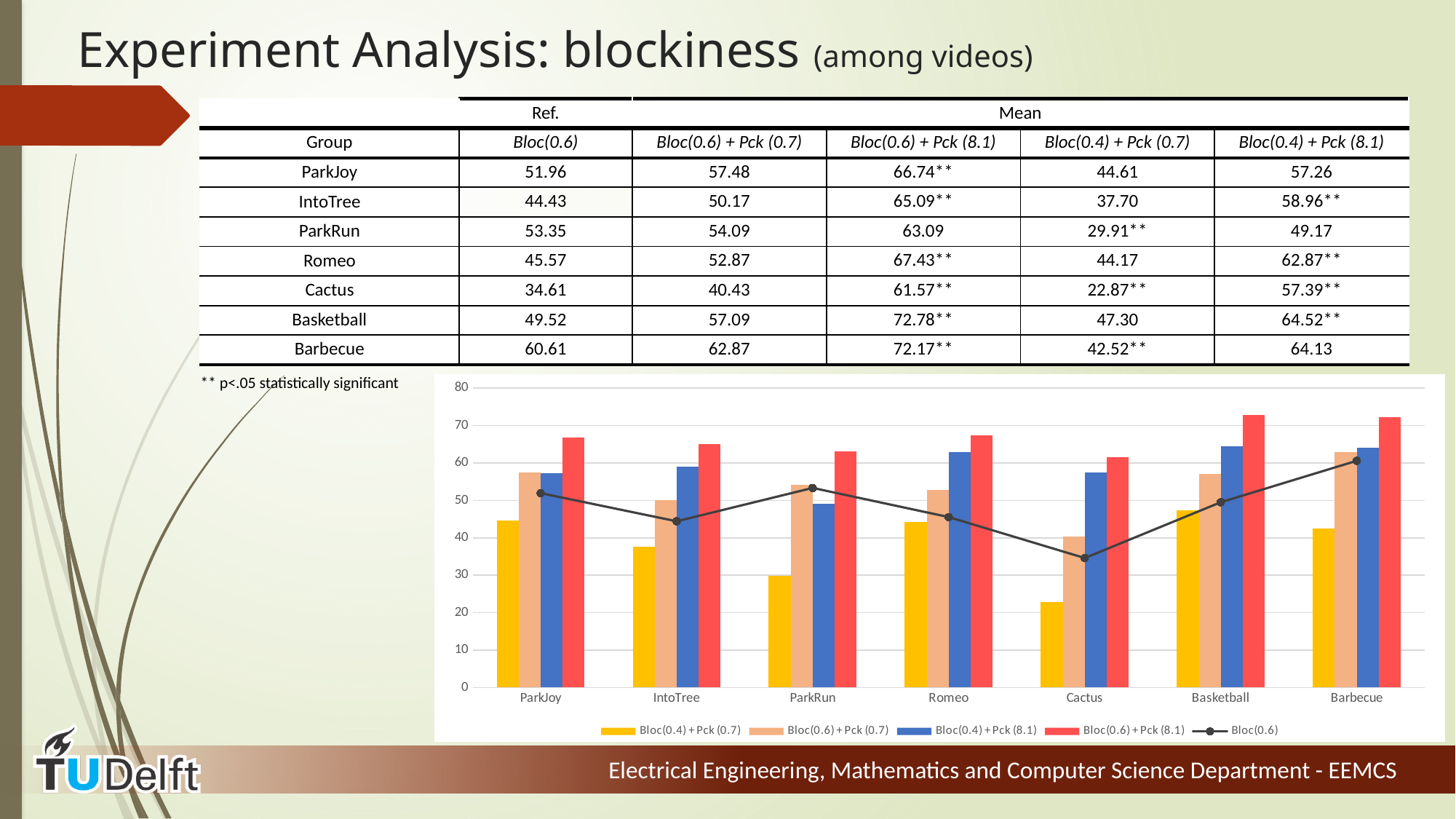
Which is larger: the Bloc(0.4) + Pck (8.1) bar for IntoTree or for ParkRun? IntoTree What kind of chart is shown on the slide? combination bar and line chart Is the value of the Bloc(0.4) + Pck (0.7) bar for ParkRun greater or less than 40? less Which series has the tallest bar for ParkJoy? Bloc(0.6) + Pck (8.1) How many video categories are shown on the x axis of the chart? 7 For which video does the Bloc(0.6) line reach its highest point? Barbecue Is the value of the Bloc(0.6) + Pck (8.1) bar for Basketball greater or less than 70? greater How many series does the chart legend list? 5 Is the value of the Bloc(0.4) + Pck (0.7) bar for Cactus greater or less than 30? less For which video is the Bloc(0.4) + Pck (0.7) bar the lowest? Cactus Does the Bloc(0.6) line rise or fall from Cactus to Barbecue? rise